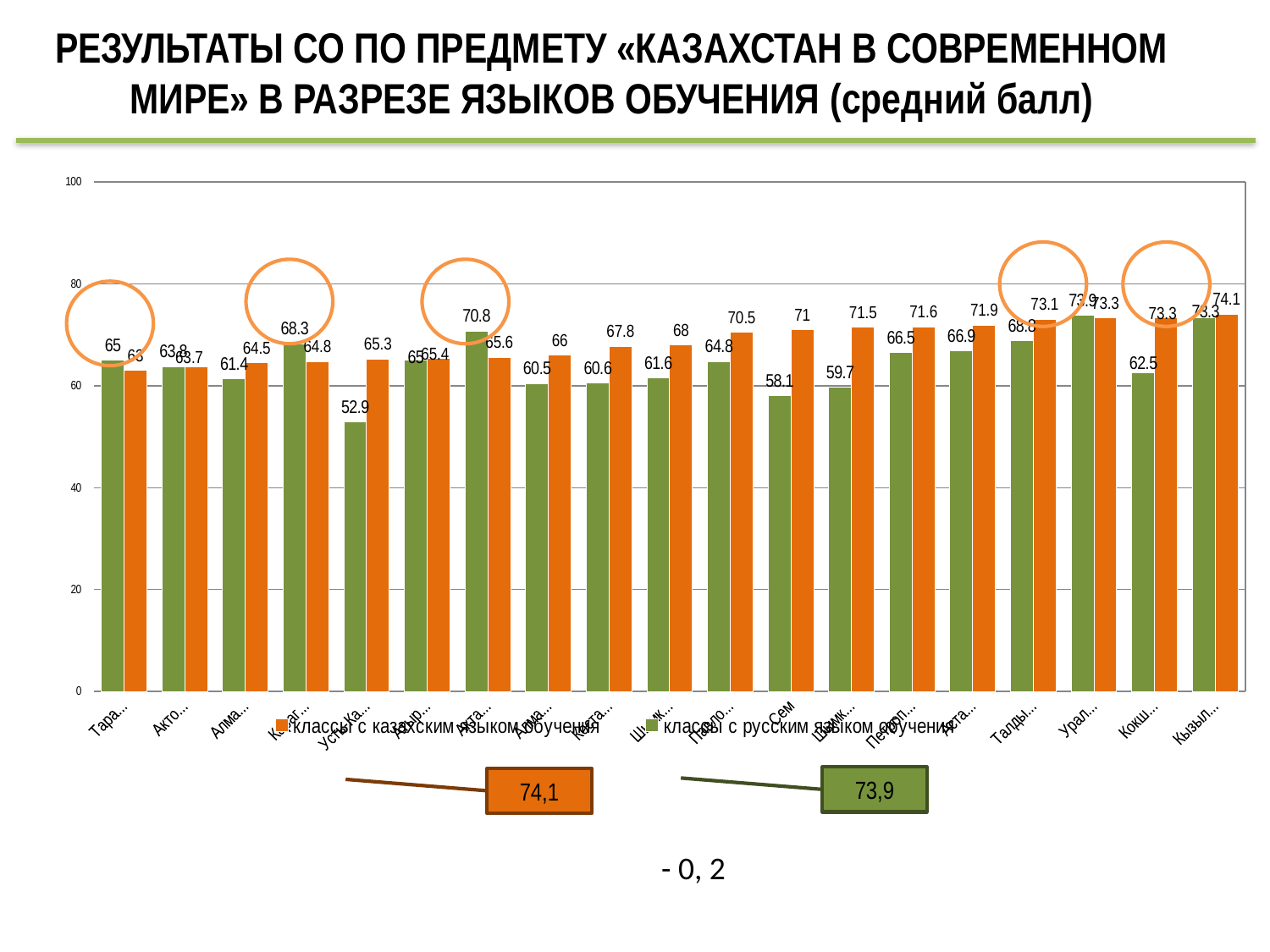
What kind of chart is shown on the slide? bar chart What is the highest value among the green bars (классы с русским языком обучения)? 73.9 What is the difference between the highest orange bar value (74.1) and the highest green bar value (73.9)? 0.2 Is the lowest green bar value greater or less than 60? less What is the lowest value among the green bars (классы с русским языком обучения)? 52.9 What is the highest value among the orange bars (классы с казахским языком обучения)? 74.1 How many series does the legend list? 2 How many categories (cities) are plotted along the x axis? 19 Which is larger: the highest orange bar value or the highest green bar value? the highest orange bar value (74.1) What value is shown in the orange callout box below the chart? 74,1 What is the lowest value among the orange bars (классы с казахским языком обучения)? 63 Do the orange bars (классы с казахским языком обучения) rise or fall from left to right along the x axis? rise